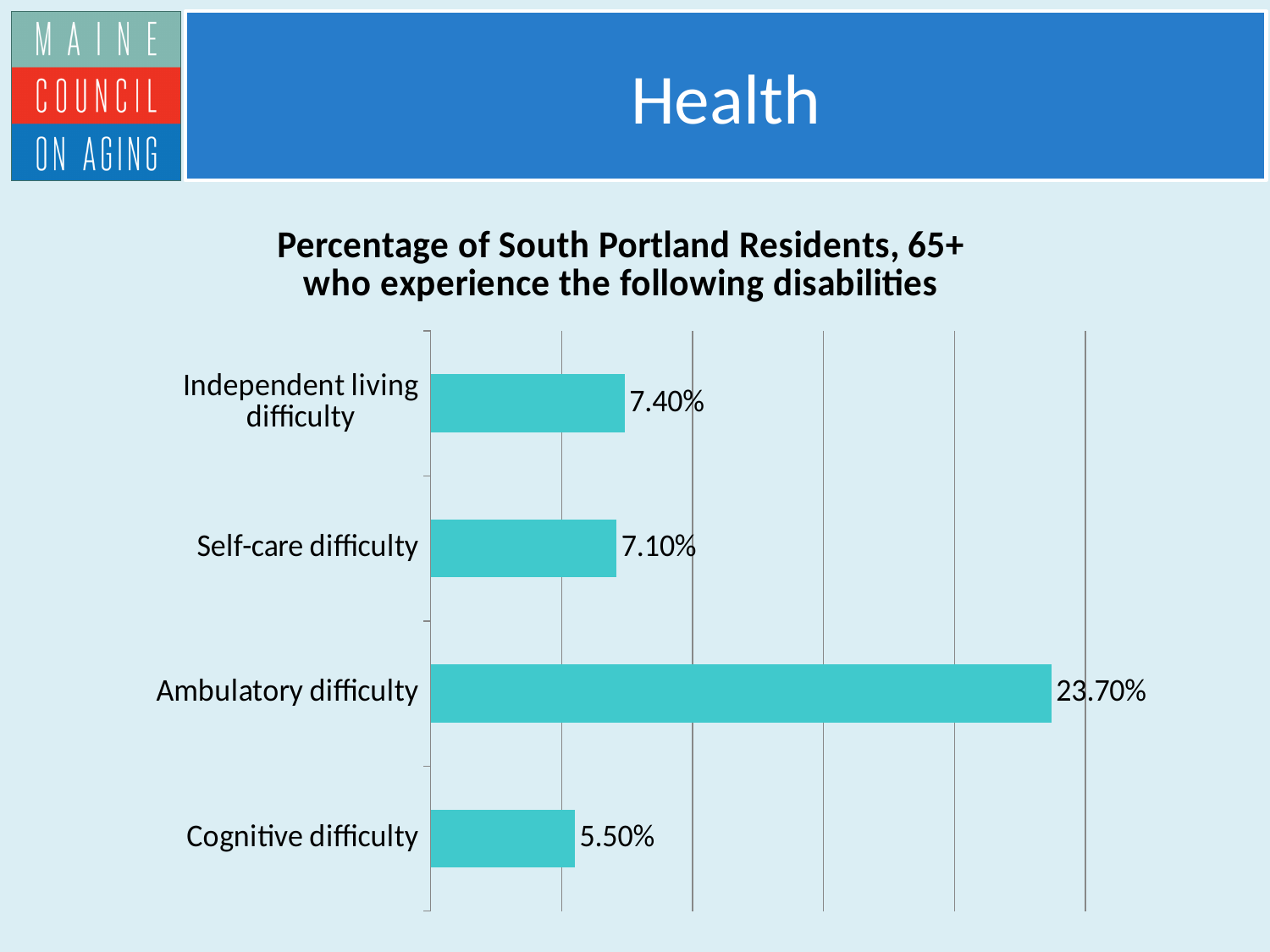
How many disability categories are shown in the chart? 4 Which disability has the lowest percentage in the chart? Cognitive difficulty What percentage of South Portland residents 65+ experience self-care difficulty? 7.10% What is the title of the chart? Percentage of South Portland Residents, 65+ who experience the following disabilities What percentage of South Portland residents 65+ experience ambulatory difficulty? 23.70% What percentage of South Portland residents 65+ experience cognitive difficulty? 5.50% What percentage of South Portland residents 65+ experience independent living difficulty? 7.40% What kind of chart is shown on the slide? Bar chart Which disability has the highest percentage in the chart? Ambulatory difficulty What is the difference between the percentages for ambulatory difficulty and cognitive difficulty? 18.20% What is the difference between the percentages for independent living difficulty and self-care difficulty? 0.30% Which is larger: the percentage for ambulatory difficulty or for self-care difficulty? Ambulatory difficulty